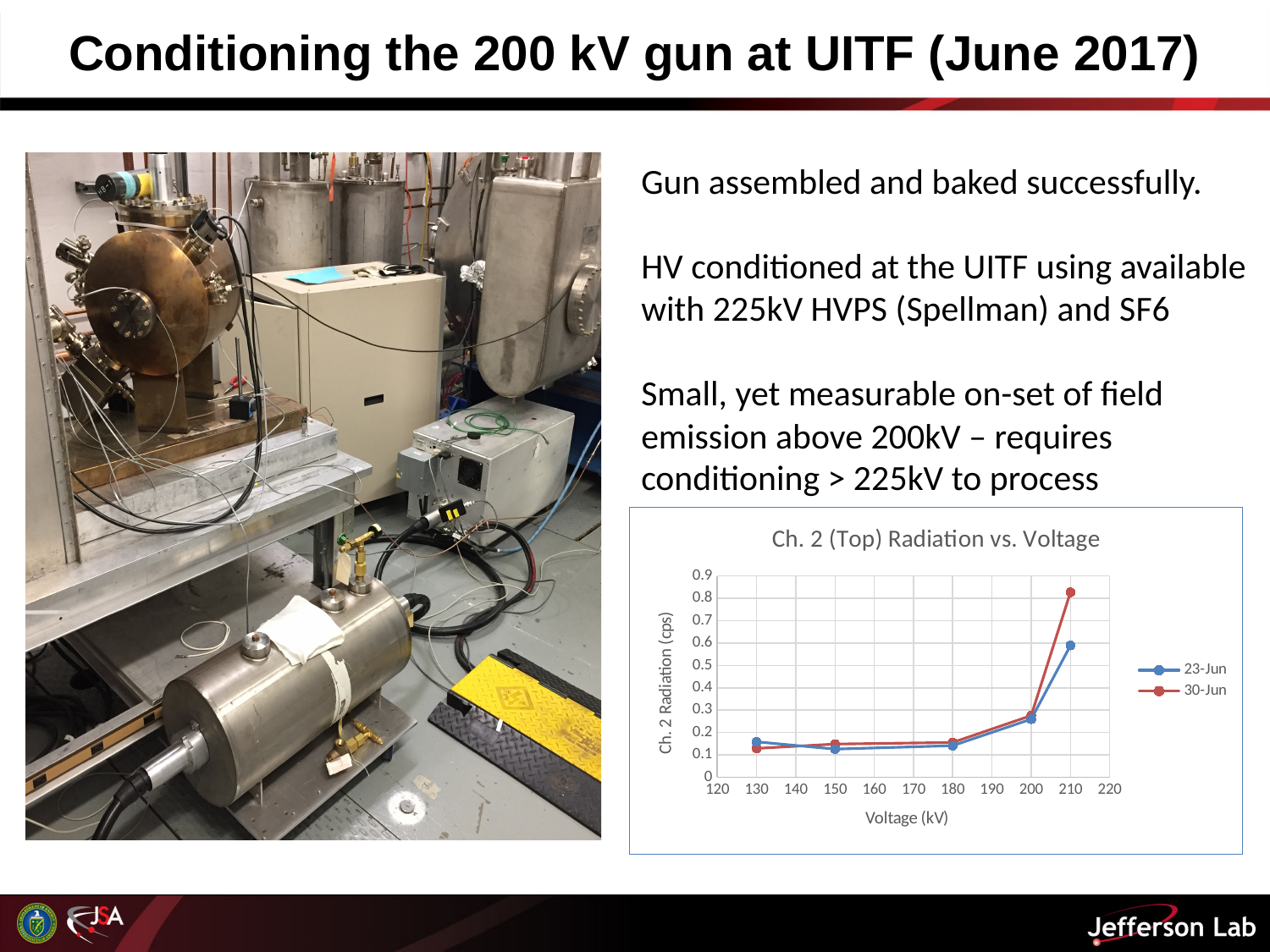
What kind of chart is shown on the slide? line chart Is the 30-Jun value at 210 kV greater or less than 0.7? greater How many data points are plotted for each series? 5 What is the title of the chart? Ch. 2 (Top) Radiation vs. Voltage What are the two series named in the chart legend? 23-Jun and 30-Jun Does the radiation rise or fall as the voltage increases from 180 kV to 210 kV? rise Is the 30-Jun value at 130 kV greater or less than 0.2? less How many series does the legend of the chart list? 2 Is the 23-Jun value at 210 kV greater or less than 0.5? greater At which voltage does the 30-Jun series reach its highest radiation value? 210 kV At 210 kV, which series has the higher radiation value, 23-Jun or 30-Jun? 30-Jun